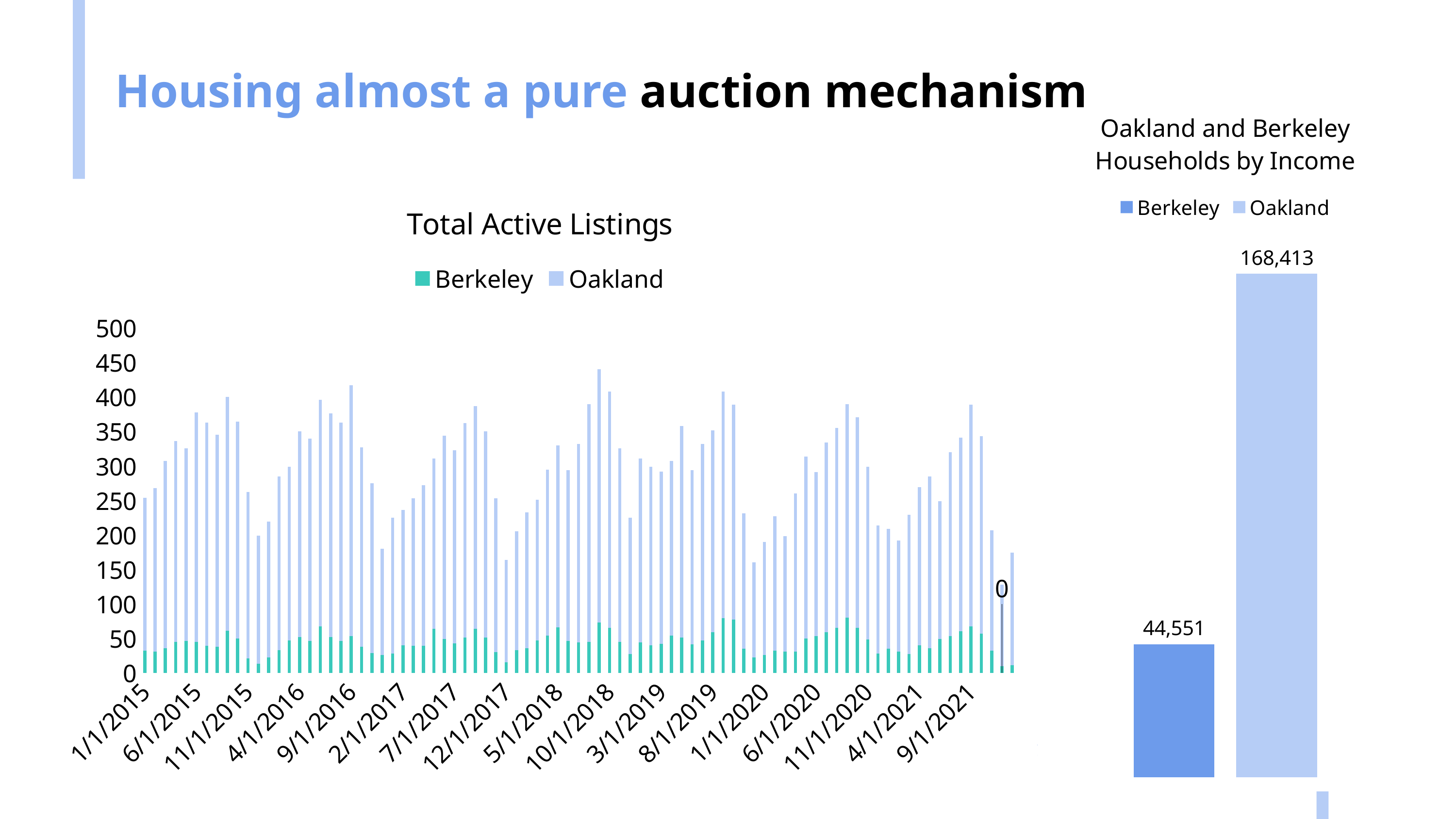
In the Oakland and Berkeley Households by Income chart, which city has the lower value? Berkeley In the Oakland and Berkeley Households by Income chart, which city has the higher value? Oakland In the Oakland and Berkeley Households by Income chart, what is the value for Oakland? 168,413 In the Total Active Listings chart, which series is shown in green? Berkeley What kind of chart is the Oakland and Berkeley Households by Income chart? Bar chart In the Oakland and Berkeley Households by Income chart, what is the difference between the Oakland and Berkeley values? 123,862 In the Total Active Listings chart, is the total stacked value for 1/1/2015 greater or less than 200? greater What kind of chart is the Total Active Listings chart? Bar chart In the Total Active Listings chart, is the Berkeley value for 1/1/2015 greater or less than 50? less In the Oakland and Berkeley Households by Income chart, how many entries does the legend list? 2 In the Oakland and Berkeley Households by Income chart, what is the value for Berkeley? 44,551 In the Total Active Listings chart, how many series does the legend list? 2